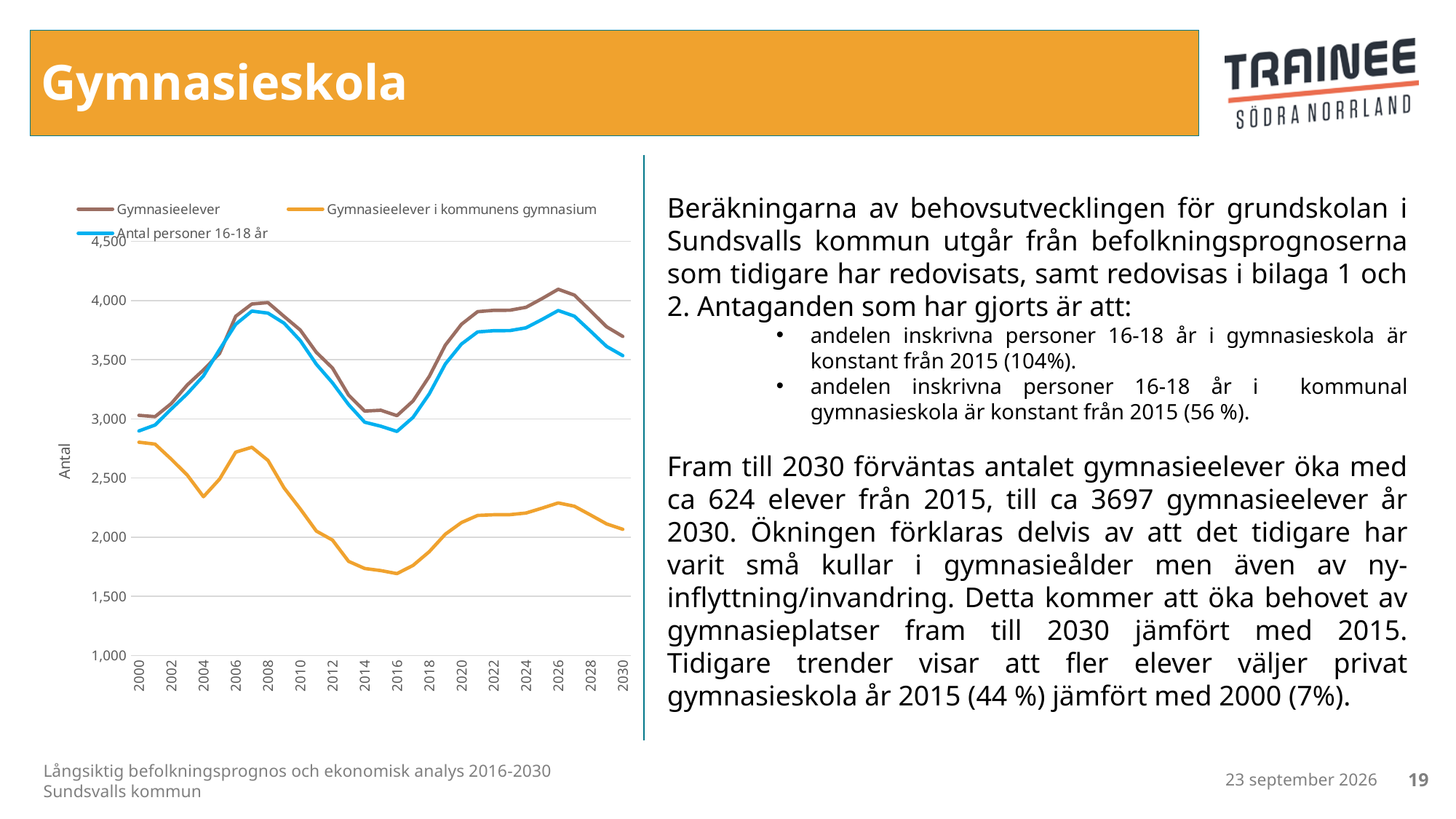
Is the value for Gymnasieelever in 2026 greater or less than 4,000? greater How many series does the chart legend list? 3 What kind of chart is shown on the slide? line chart In 2016, which is larger: Gymnasieelever or Gymnasieelever i kommunens gymnasium? Gymnasieelever Is the value for Gymnasieelever i kommunens gymnasium in 2016 greater or less than 2,000? less Is the value for Gymnasieelever i kommunens gymnasium in 2004 greater or less than 2,500? less In 2026, which is larger: Gymnasieelever or Antal personer 16-18 år? Gymnasieelever Which series is drawn in orange in the chart? Gymnasieelever i kommunens gymnasium In which year does the Gymnasieelever i kommunens gymnasium line reach its lowest value? 2016 Does the Gymnasieelever i kommunens gymnasium line rise or fall between 2016 and 2026? rise What is the label on the vertical axis of the chart? Antal